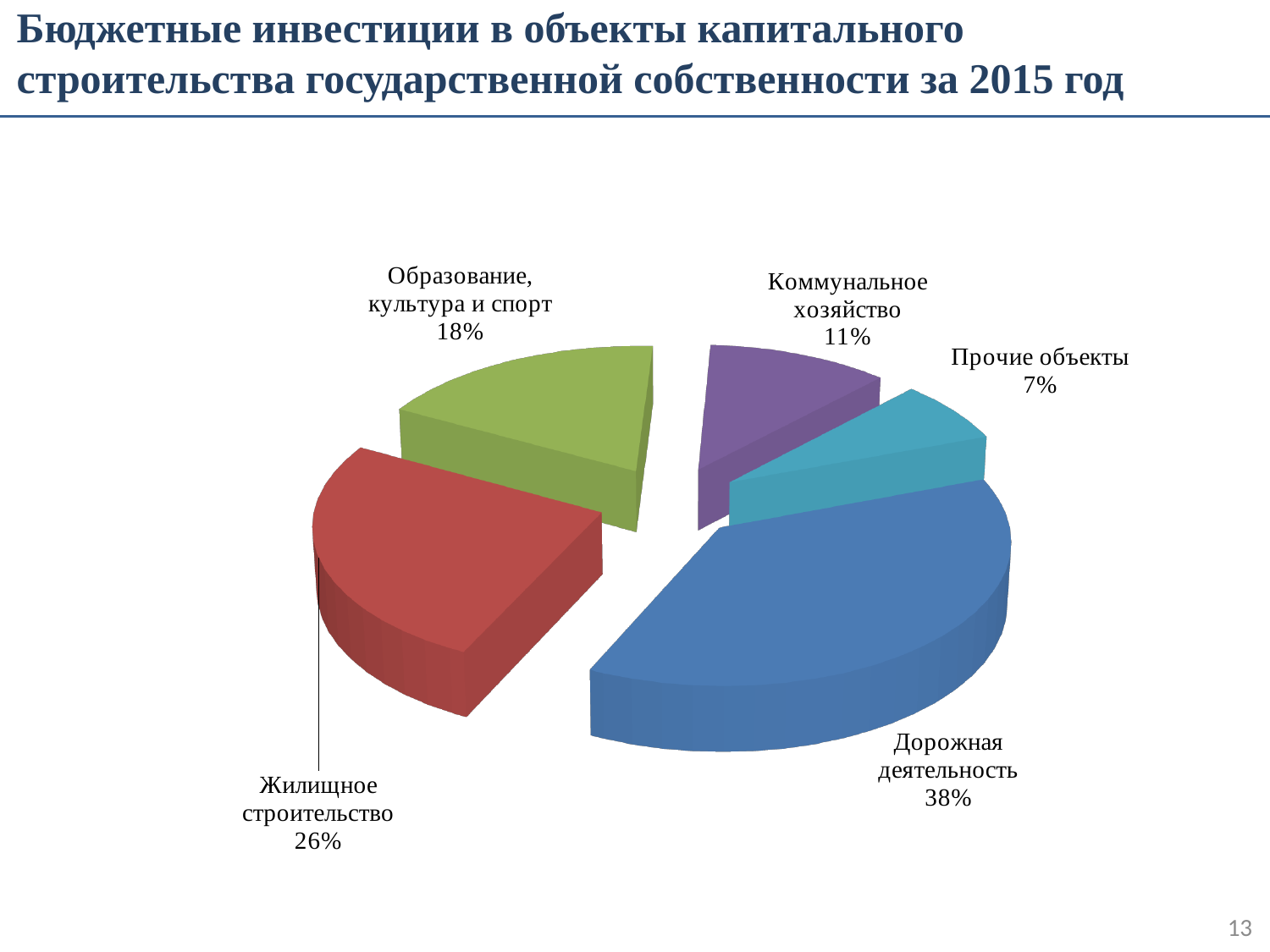
What is the difference in percentage points between Дорожная деятельность and Жилищное строительство? 12 How many categories (slices) does the pie chart have? 5 What share of the pie does Образование, культура и спорт have? 18% What share of the pie does Коммунальное хозяйство have? 11% Which category has the largest share of the pie? Дорожная деятельность What share of the pie does Жилищное строительство have? 26% What colour is the slice for Дорожная деятельность? Blue Which is larger, the share for Образование, культура и спорт or the share for Коммунальное хозяйство? Образование, культура и спорт What kind of chart is shown on the slide? Pie chart Which category has the smallest share of the pie? Прочие объекты